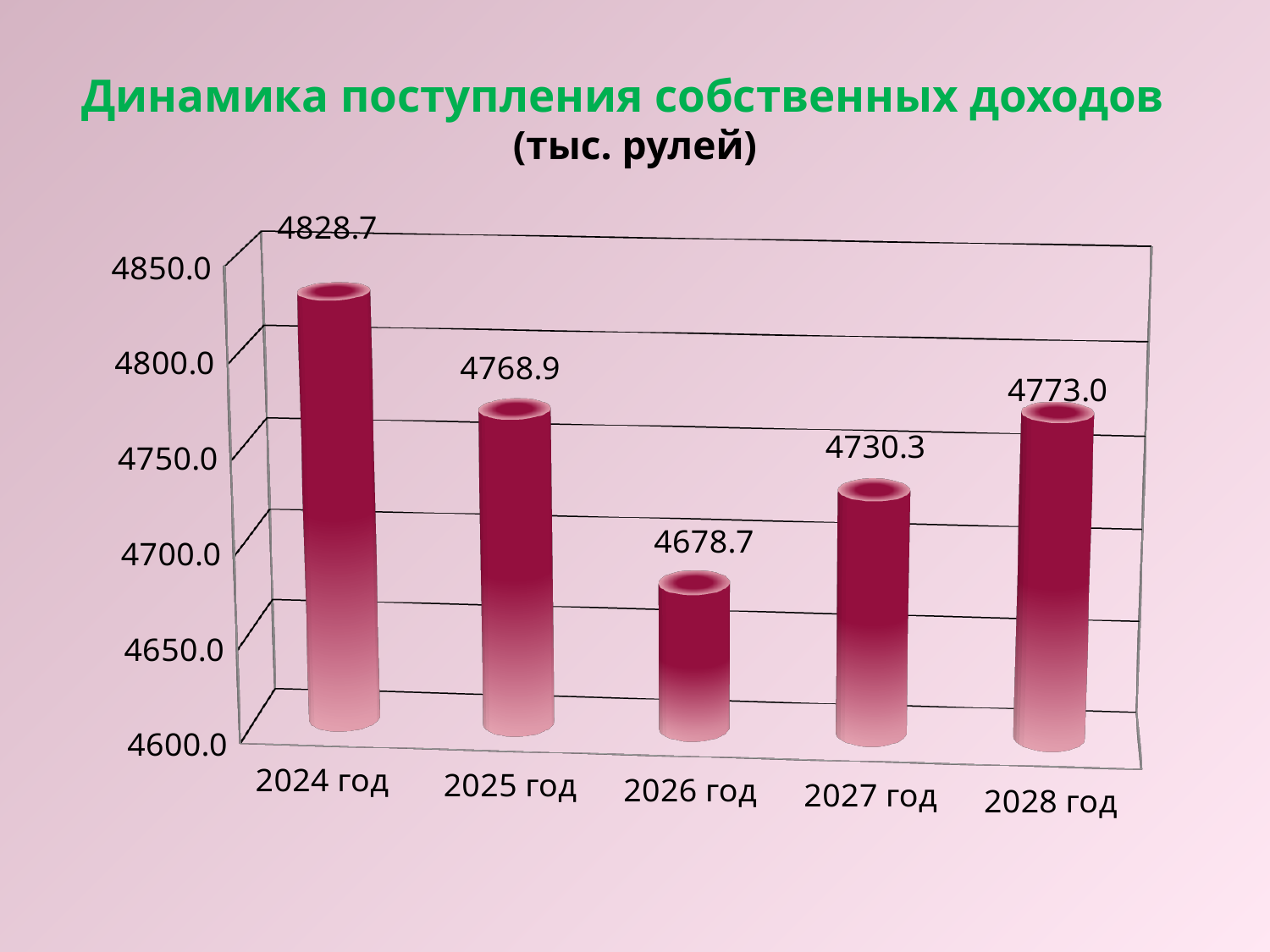
What is the value for 2026 год? 4678.7 Which year has the highest value? 2024 год Is the value for 2027 год greater or less than 4750.0? less What is the title of the chart? Динамика поступления собственных доходов (тыс. рулей) Which year has the lowest value? 2026 год Which is larger, the value for 2025 год or the value for 2028 год? 2028 год What is the difference between the values for 2028 год and 2027 год? 42.7 How many years are shown on the chart? 5 What is the value for 2028 год? 4773.0 What is the value for 2024 год? 4828.7 What kind of chart is shown on the slide? bar chart What is the difference between the values for 2024 год and 2025 год? 59.8